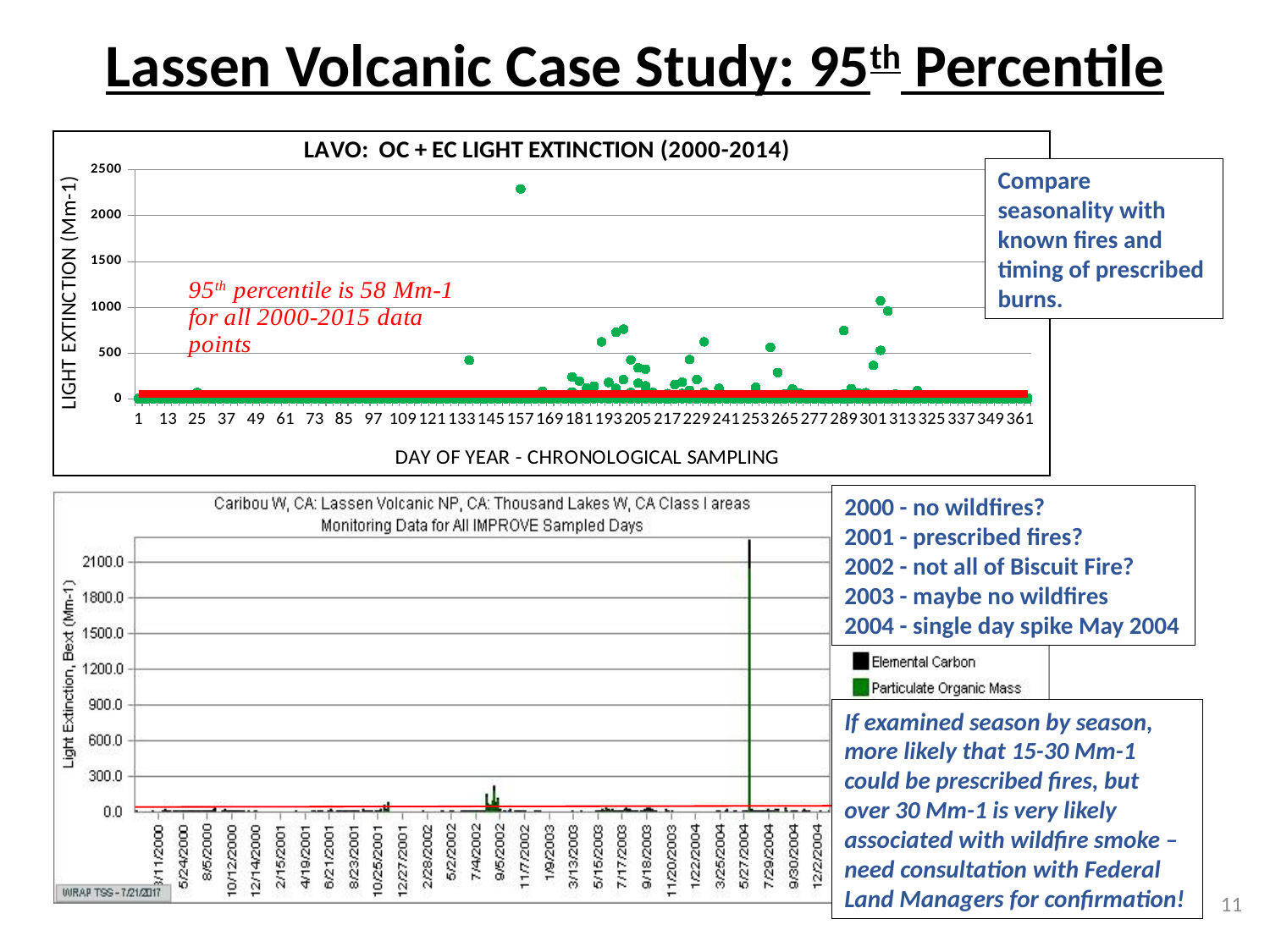
In the bottom chart, is the tallest spike greater or less than 1800.0? greater According to the annotation on the top chart, what is the 95th percentile value for all 2000-2015 data points? 58 Mm-1 In the top chart, what is the label of the y-axis? LIGHT EXTINCTION (Mm-1) In the top chart, what is the highest value shown on the y-axis? 2500 In the top chart, what is the label of the x-axis? DAY OF YEAR - CHRONOLOGICAL SAMPLING In the top chart, is the highest plotted point greater or less than 2000? greater What kind of chart is the top chart titled "LAVO: OC + EC LIGHT EXTINCTION (2000-2014)"? scatter chart How many series does the legend of the bottom chart list? 2 In the bottom chart, what is the label of the y-axis? Light Extinction, Bext (Mm-1) In the bottom chart, at which date on the x-axis does the tallest spike occur? 5/27/2004 In the top chart, is the red horizontal line greater or less than 500 on the y-axis? less In the bottom chart, what is the highest value shown on the y-axis? 2100.0